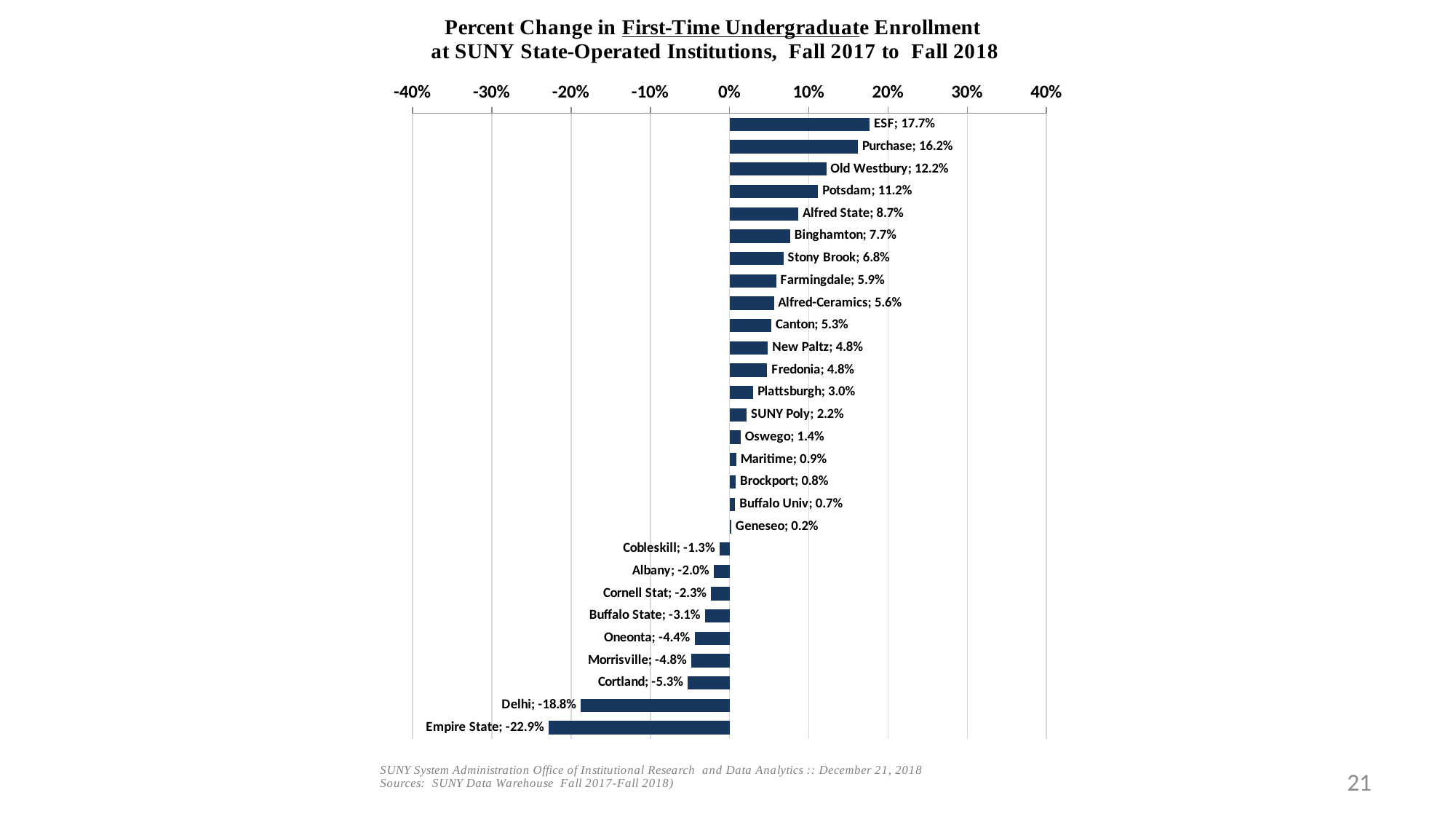
Which institution has the highest percent change in first-time undergraduate enrollment? ESF What is the percent change shown for Delhi? -18.8% What time period does the chart title say the percent change covers? Fall 2017 to Fall 2018 Which has a larger percent change, Stony Brook or Alfred State? Alfred State What kind of chart is shown on the slide? Bar chart What is the difference between the percent change for ESF and for Purchase? 1.5% What is the percent change shown for Binghamton? 7.7% What is the percent change in first-time undergraduate enrollment for Purchase? 16.2% How many institutions are shown in the chart? 28 Which institution has the lowest percent change in first-time undergraduate enrollment? Empire State Which has a larger percent change, Cortland or Oneonta? Oneonta What is the difference between the percent change for Old Westbury and for Potsdam? 1.0%